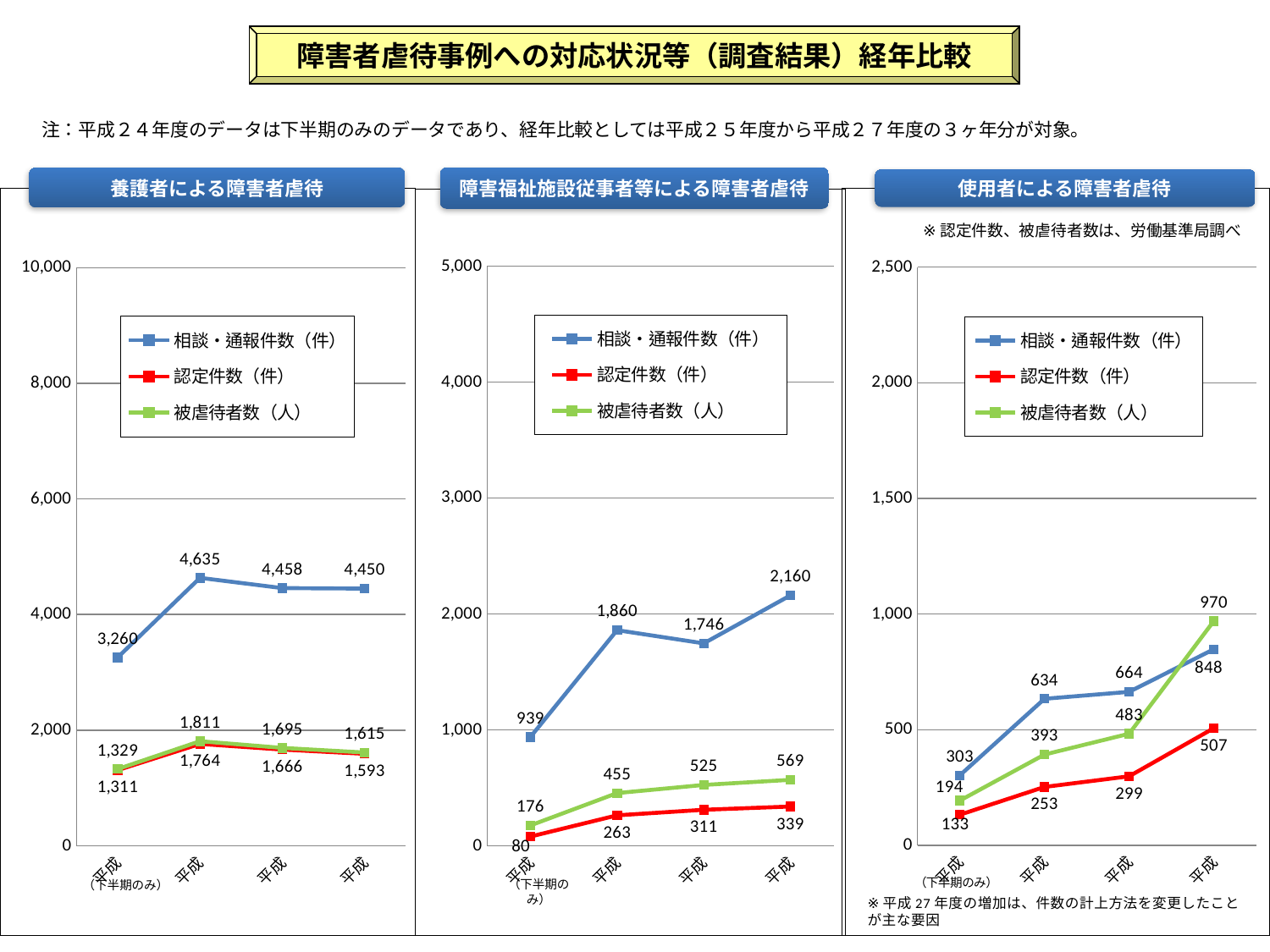
In the 養護者による障害者虐待 chart, what is the value of 被虐待者数（人） at the last point? 1,615 In the 障害福祉施設従事者等による障害者虐待 chart, what is the value of 認定件数（件） at the first point (下半期のみ)? 80 What kind of chart is the 障害福祉施設従事者等による障害者虐待 chart? Line chart In the 障害福祉施設従事者等による障害者虐待 chart, at which point is 相談・通報件数（件） highest? The last (fourth) point, 2,160 In the 使用者による障害者虐待 chart, which is larger at the last point: 相談・通報件数（件） or 被虐待者数（人）? 被虐待者数（人） In the 使用者による障害者虐待 chart, what is the difference between 認定件数（件） at the last point (507) and at the third point (299)? 208 In the 養護者による障害者虐待 chart, what is the difference between 相談・通報件数（件） at the second point (4,635) and at the first point (3,260)? 1,375 In the 養護者による障害者虐待 chart, what is the value of 相談・通報件数（件） at the second point? 4,635 In the 使用者による障害者虐待 chart, what is the value of 被虐待者数（人） at the last point? 970 How many data points does each series in the 使用者による障害者虐待 chart have? 4 How many series does the legend of the 養護者による障害者虐待 chart list? 3 In the 障害福祉施設従事者等による障害者虐待 chart, does 被虐待者数（人） rise or fall across the four points? Rise